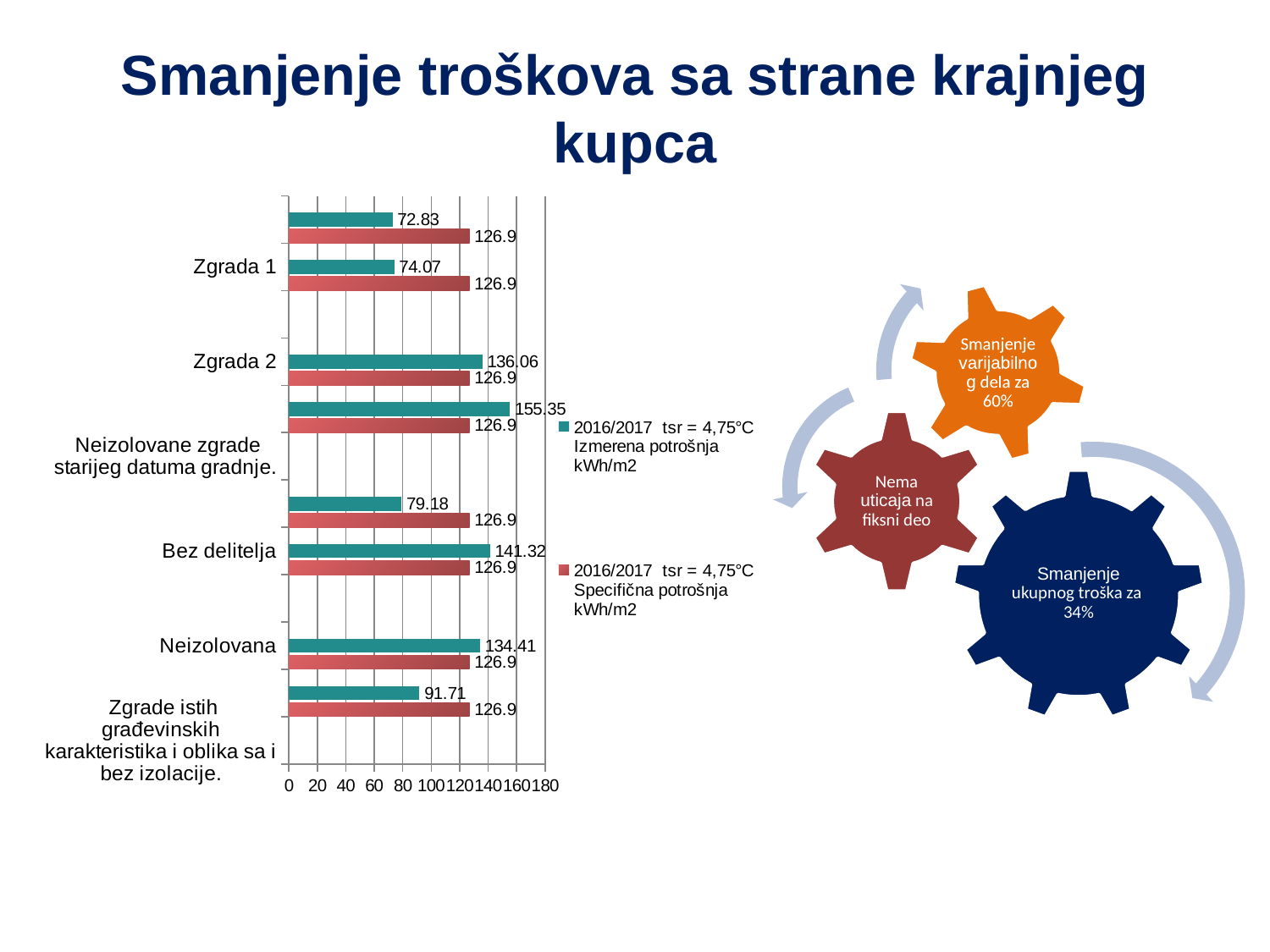
How many Izmerena potrošnja bars are plotted in the chart? 8 What is the Izmerena potrošnja value for Neizolovana? 134.41 Which has a larger Izmerena potrošnja value, Bez delitelja or Neizolovana? Bez delitelja What is the Izmerena potrošnja value for Zgrada 2? 136.06 What is the lowest Izmerena potrošnja value shown in the chart? 72.83 What is the maximum value shown on the chart's value axis? 180 What type of chart is shown on the slide? bar chart What is the highest Izmerena potrošnja value shown in the chart? 155.35 What is the difference between the Izmerena potrošnja and Specifična potrošnja values for Bez delitelja? 14.42 How many series does the chart legend list? 2 What is the Specifična potrošnja value for Zgrada 2? 126.9 What is the Izmerena potrošnja value for Bez delitelja? 141.32